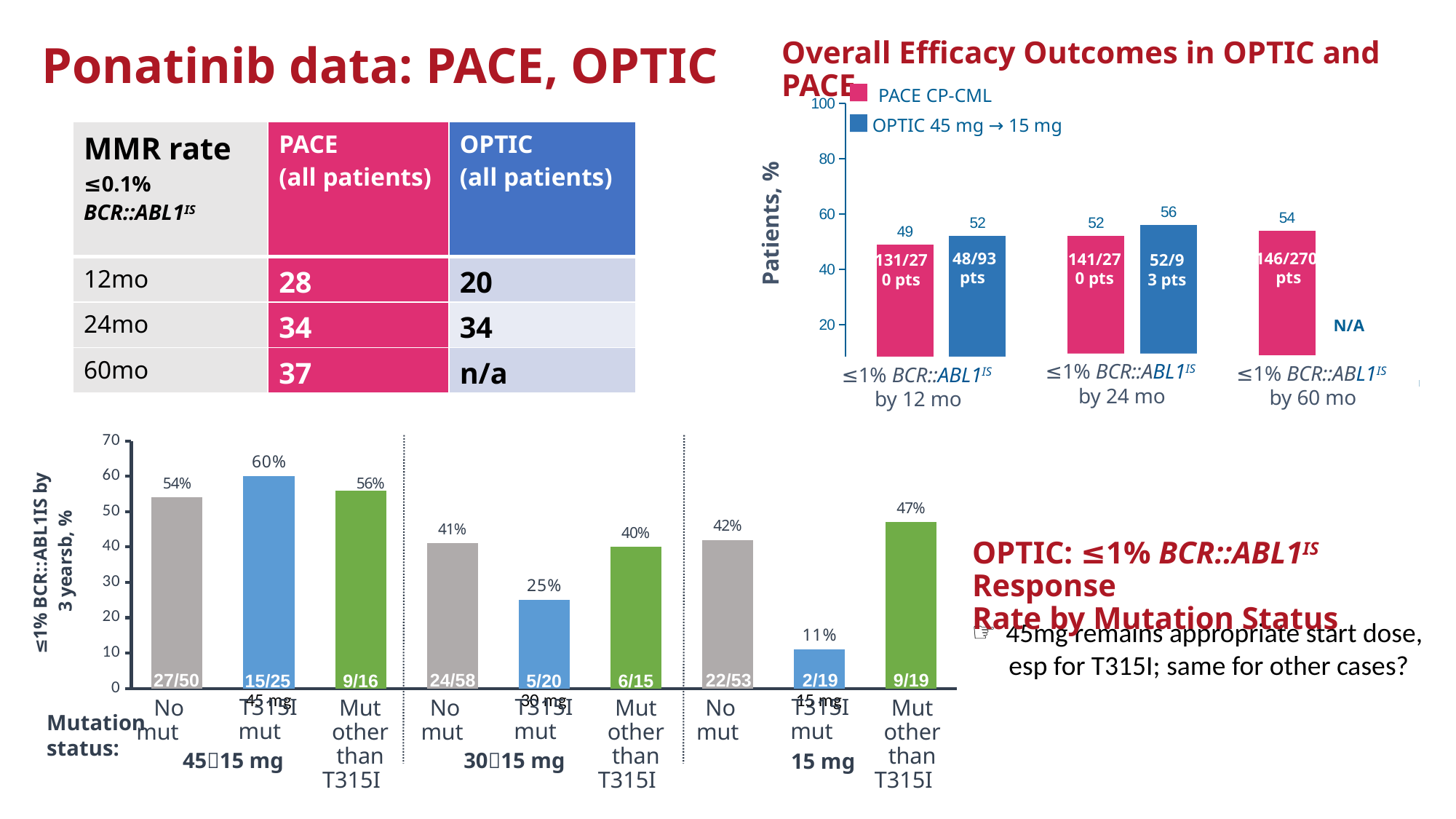
In the 'OPTIC: ≤1% BCR::ABL1 Response Rate by Mutation Status' chart, what is the value for T315I mut in the 45→15 mg group? 60% What kind of chart is the 'OPTIC: ≤1% BCR::ABL1 Response Rate by Mutation Status' chart? bar chart In the 'Overall Efficacy Outcomes in OPTIC and PACE' chart, what is the difference between the OPTIC and PACE values at 24 mo? 4 In the 'OPTIC: ≤1% BCR::ABL1 Response Rate by Mutation Status' chart, which bar has the highest value? T315I mut in the 45→15 mg group (60%) In the 'Overall Efficacy Outcomes in OPTIC and PACE' chart, how many series does the legend list? 2 In the 'OPTIC: ≤1% BCR::ABL1 Response Rate by Mutation Status' chart, how many bars are plotted? 9 In the 'Overall Efficacy Outcomes in OPTIC and PACE' chart, do the PACE CP-CML values rise or fall from 12 mo to 60 mo? rise In the 'OPTIC: ≤1% BCR::ABL1 Response Rate by Mutation Status' chart, what is the value for No mut in the 30→15 mg group? 41% In the 'OPTIC: ≤1% BCR::ABL1 Response Rate by Mutation Status' chart, which bar has the lowest value? T315I mut in the 15 mg group (11%) In the 'Overall Efficacy Outcomes in OPTIC and PACE' chart, what is the PACE CP-CML value for ≤1% BCR::ABL1 by 60 mo? 54 In the 'Overall Efficacy Outcomes in OPTIC and PACE' chart, what is the OPTIC 45 mg → 15 mg value for ≤1% BCR::ABL1 by 24 mo? 56 In the 'Overall Efficacy Outcomes in OPTIC and PACE' chart, what is the PACE CP-CML value for ≤1% BCR::ABL1 by 12 mo? 49